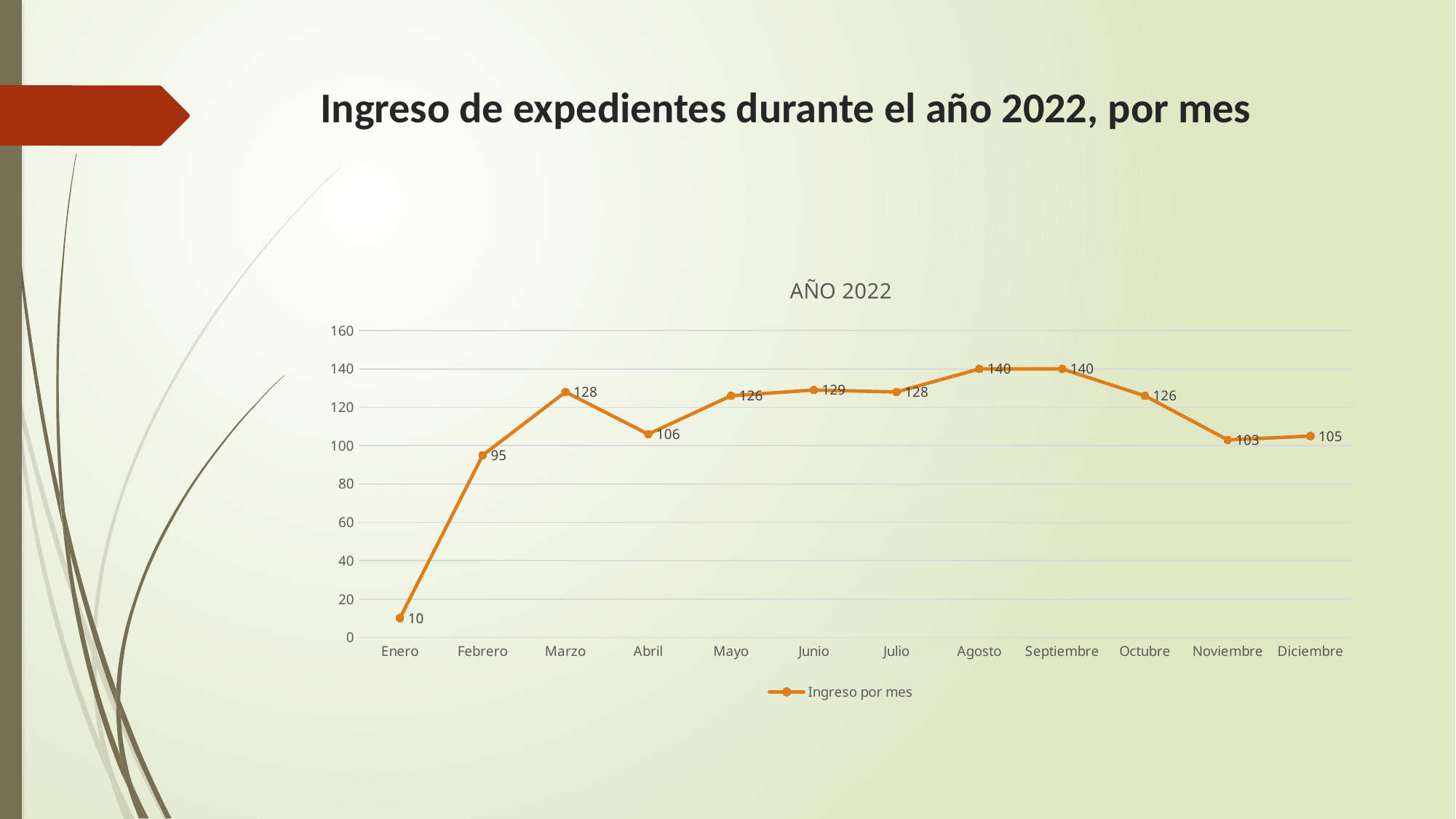
Do the values rise or fall from Septiembre to Noviembre? fall What is the value for Enero? 10 What is the title of the chart? AÑO 2022 How many series does the legend list? 1 What kind of chart is shown? line chart Which is larger, the value for Febrero or the value for Diciembre? Diciembre How many months are plotted on the x axis? 12 Is the value for Octubre greater or less than 120? greater What is the difference between the values for Marzo and Abril? 22 Which month has the lowest value? Enero What is the value for Marzo? 128 What is the value for Noviembre? 103